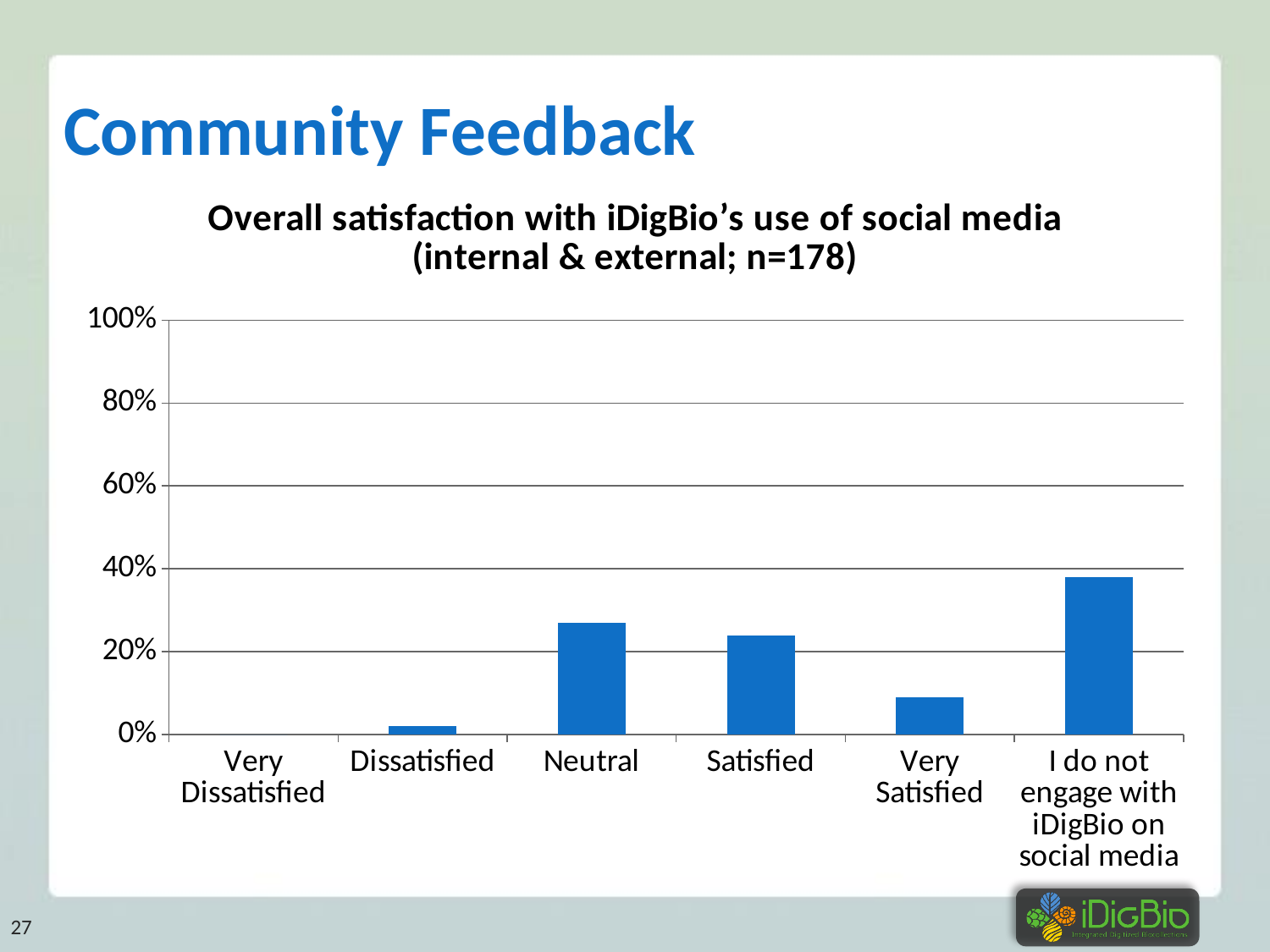
Which is larger, the value for Neutral or the value for Very Satisfied? Neutral Is the value for Neutral greater or less than 20%? greater Is the value for Very Satisfied greater or less than 20%? less Is the value for 'I do not engage with iDigBio on social media' greater or less than 20%? greater What is the title of the chart? Overall satisfaction with iDigBio's use of social media (internal & external; n=178) Which category has the highest bar in the chart? I do not engage with iDigBio on social media Which category has the lowest value in the chart? Very Dissatisfied Which is larger, the value for Satisfied or the value for Dissatisfied? Satisfied What kind of chart is shown on the slide? bar chart How many categories are shown on the x axis of the chart? 6